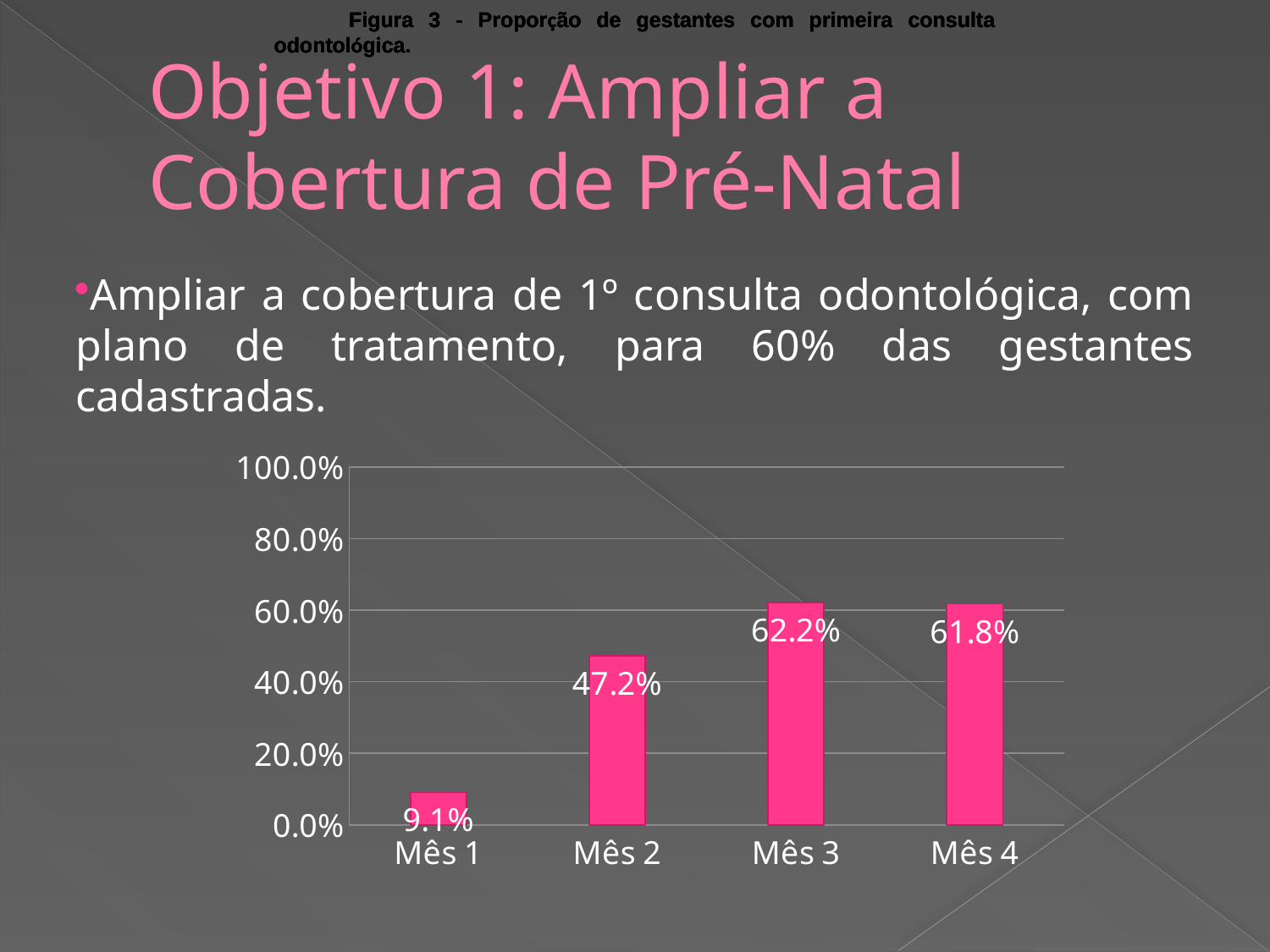
What is the difference between the values for Mês 3 and Mês 4? 0.4% Which is larger, the value for Mês 2 or the value for Mês 4? Mês 4 What kind of chart is shown on the slide? Bar chart What is the value for Mês 2? 47.2% What is the value for Mês 1? 9.1% What is the value for Mês 3? 62.2% Do the values rise or fall from Mês 1 to Mês 3? Rise What is the difference between the values for Mês 2 and Mês 1? 38.1% What is the value for Mês 4? 61.8% Which month has the highest value? Mês 3 How many months are shown on the x axis? 4 Which month has the lowest value? Mês 1